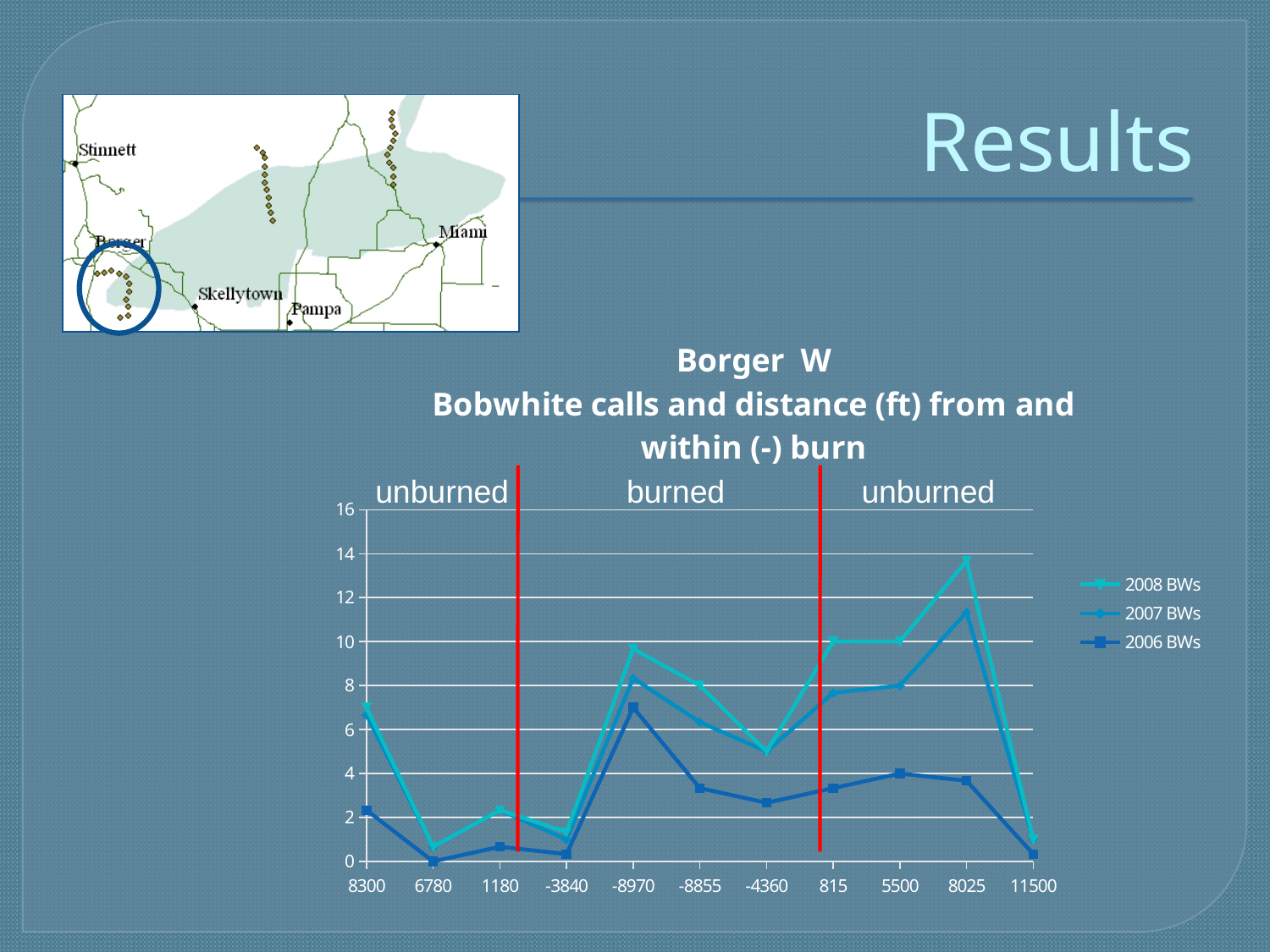
Which series is listed first in the legend? 2008 BWs Is the value for 2008 BWs at 8025 greater or less than 12? greater How many series does the legend list? 3 Does the 2008 BWs series rise or fall between 8025 and 11500? fall What kind of chart is shown on the slide? line chart Is the value for 2006 BWs at 5500 greater or less than 6? less At which distance does the 2008 BWs series reach its highest value? 8025 At 8025, which series has the larger value, 2008 BWs or 2006 BWs? 2008 BWs At which distance does the 2006 BWs series reach its highest value? -8970 At -8970, which series has the larger value, 2008 BWs or 2006 BWs? 2008 BWs How many distance categories are shown on the x axis? 11 Is the value for 2007 BWs at 11500 greater or less than 2? less